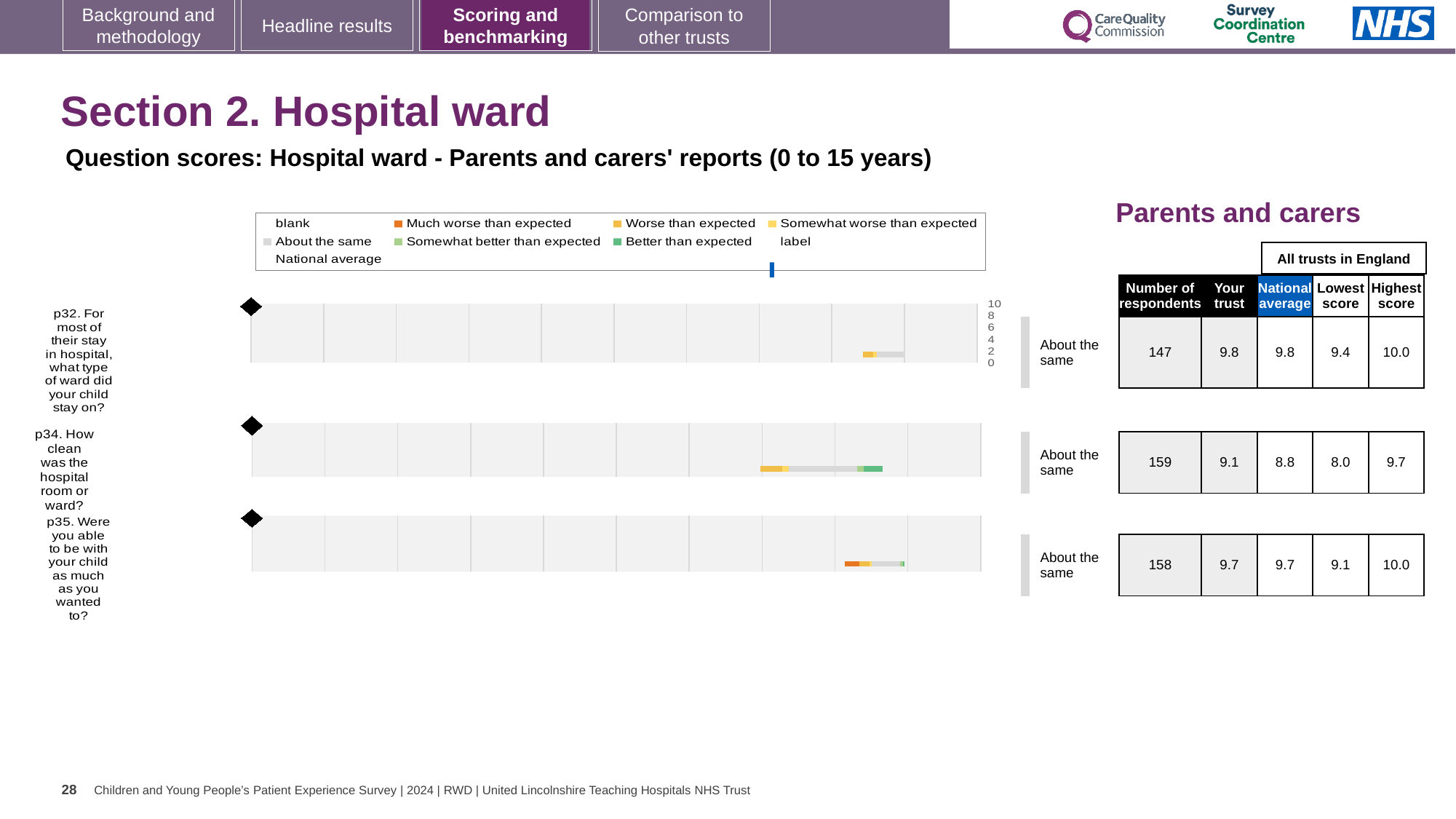
Which question has the lowest 'Your trust' score on this slide? p34 Which question has the highest 'Your trust' score on this slide? p32 For p34, which is larger: the 'Your trust' score or the national average? Your trust For p34, what is the difference between the 'Your trust' score and the national average? 0.3 What type of chart is used for the question scores on this slide? bar chart What is the 'Your trust' score for p34 (How clean was the hospital room or ward?)? 9.1 What is the national average score for p35 (Were you able to be with your child as much as you wanted to?)? 9.7 What benchmark category is shown next to each of the three question bars? About the same How many questions (p32, p34, p35) are plotted as bars on this slide? 3 How many respondents answered p34 (How clean was the hospital room or ward?)? 159 What is the lowest score among all trusts in England for p34 (How clean was the hospital room or ward?)? 8.0 What is the 'Your trust' score for p32 (For most of their stay in hospital, what type of ward did your child stay on?)? 9.8